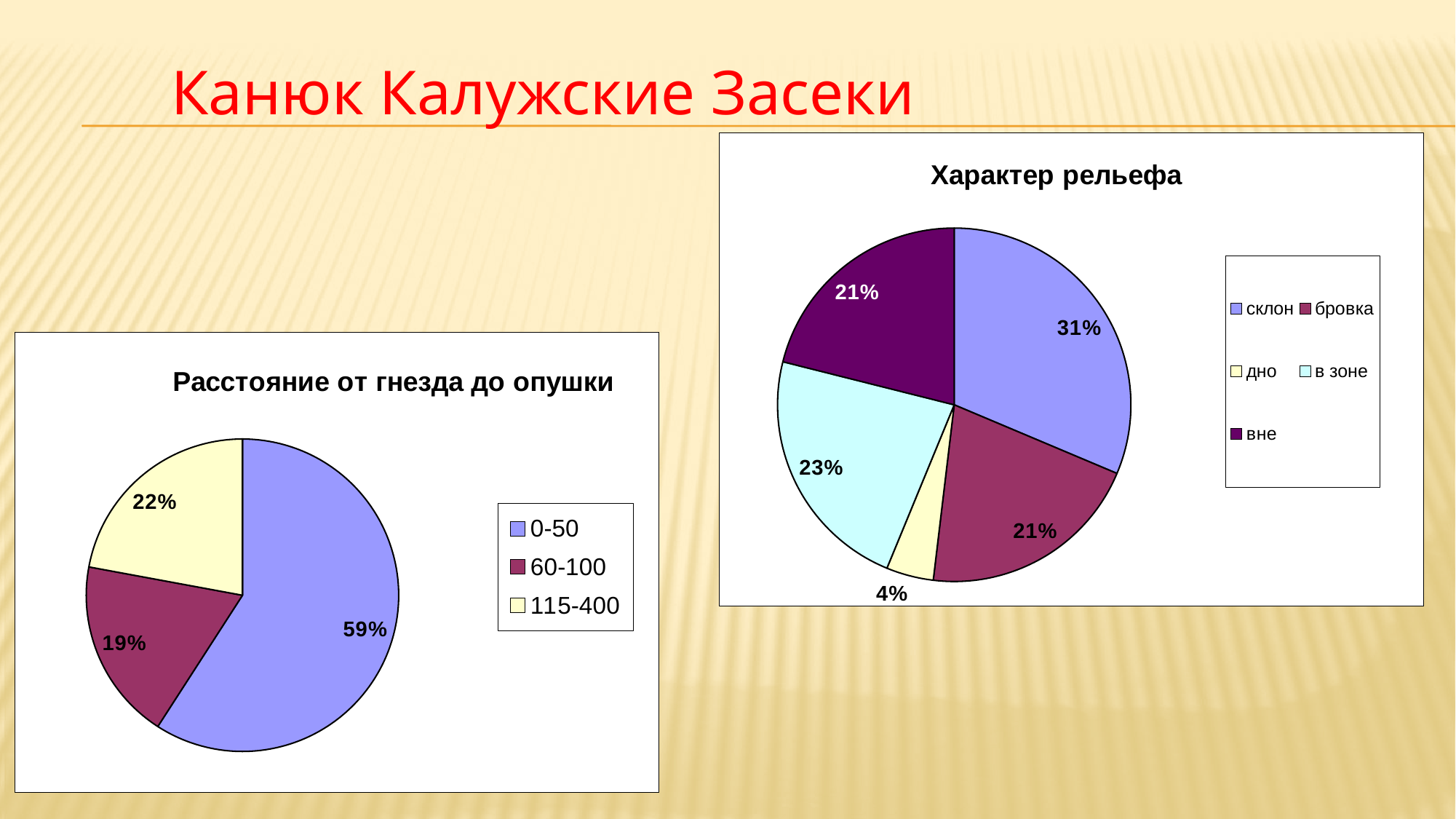
In the chart titled "Расстояние от гнезда до опушки", how many categories does the legend list? 3 In the chart titled "Расстояние от гнезда до опушки", what share of the pie does the 0-50 slice take? 59% In the chart titled "Характер рельефа", what is the value for дно? 4% In the chart titled "Характер рельефа", which is larger, the slice for в зоне or the slice for дно? в зоне In the chart titled "Характер рельефа", what is the value for склон? 31% What kind of chart is the chart titled "Характер рельефа"? pie chart In the chart titled "Расстояние от гнезда до опушки", which category has the largest slice? 0-50 In the chart titled "Расстояние от гнезда до опушки", what is the value for 60-100? 19% In the chart titled "Расстояние от гнезда до опушки", which category has the smallest slice? 60-100 In the chart titled "Расстояние от гнезда до опушки", what is the difference between the 0-50 and 115-400 slices? 37% In the chart titled "Характер рельефа", which category has the largest slice? склон In the chart titled "Характер рельефа", which category has the smallest slice? дно